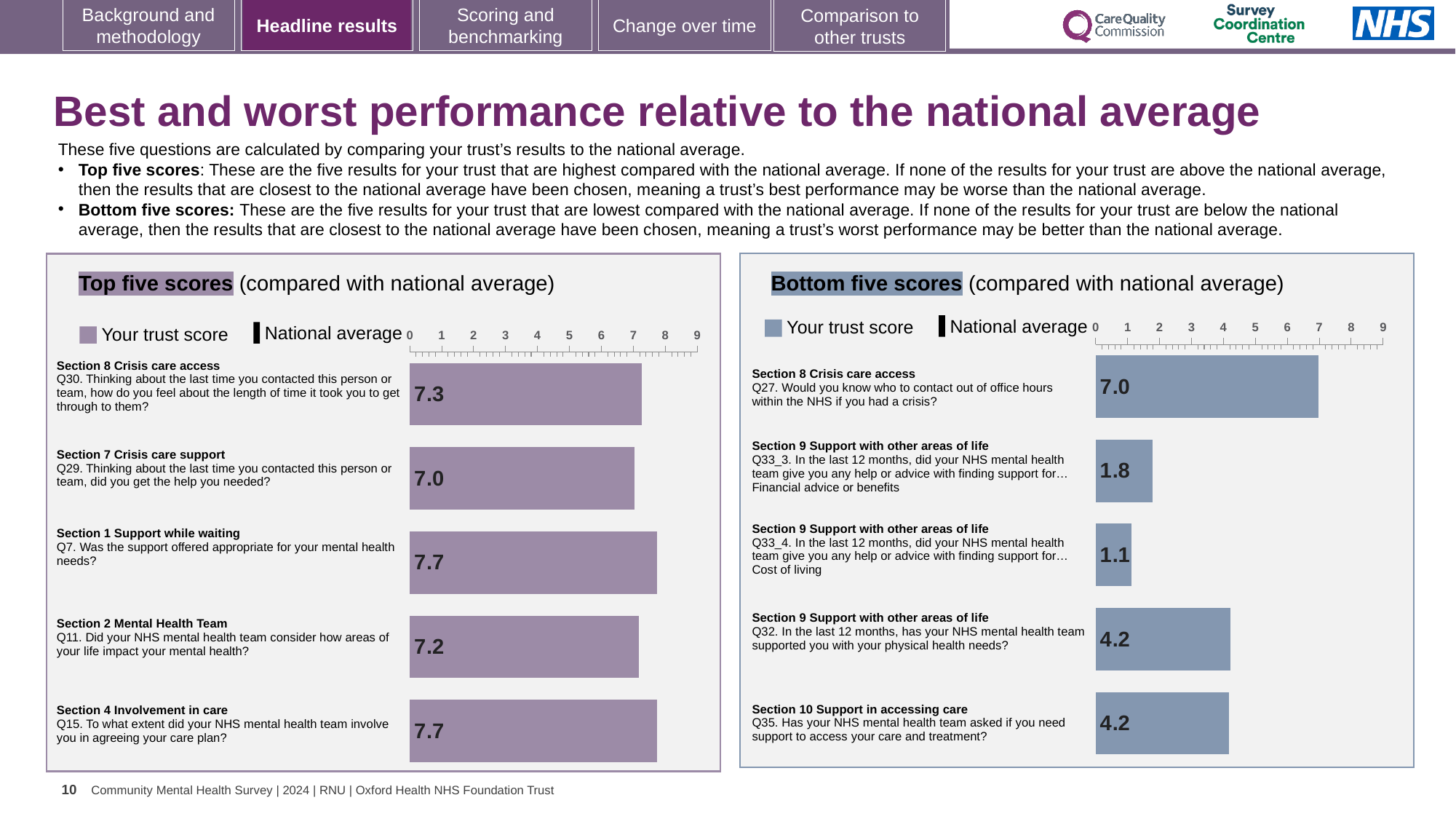
In the Bottom five scores chart, which question has the highest trust score? Q27 (Section 8 Crisis care access) What type of chart is the Top five scores chart? Bar chart In the Top five scores chart, what is the trust score for Q11 (Section 2 Mental Health Team)? 7.2 In the Bottom five scores chart, what is the difference between the trust scores for Q27 and Q33_4? 5.9 In the Top five scores chart, which question has the lowest trust score? Q29 (Section 7 Crisis care support) In the Bottom five scores chart, is the trust score for Q32 larger or smaller than the score for Q33_3? larger In the Top five scores chart, what is the difference between the trust scores for Q7 and Q29? 0.7 In the Bottom five scores chart, what is the trust score for Q33_3 (Financial advice or benefits)? 1.8 In the Top five scores chart, what is the trust score for Q30 (Section 8 Crisis care access)? 7.3 In the Bottom five scores chart, which question has the lowest trust score? Q33_4 (Cost of living) How many questions are shown in the Bottom five scores chart? 5 In the Bottom five scores chart, what is the trust score for Q27 (Section 8 Crisis care access)? 7.0